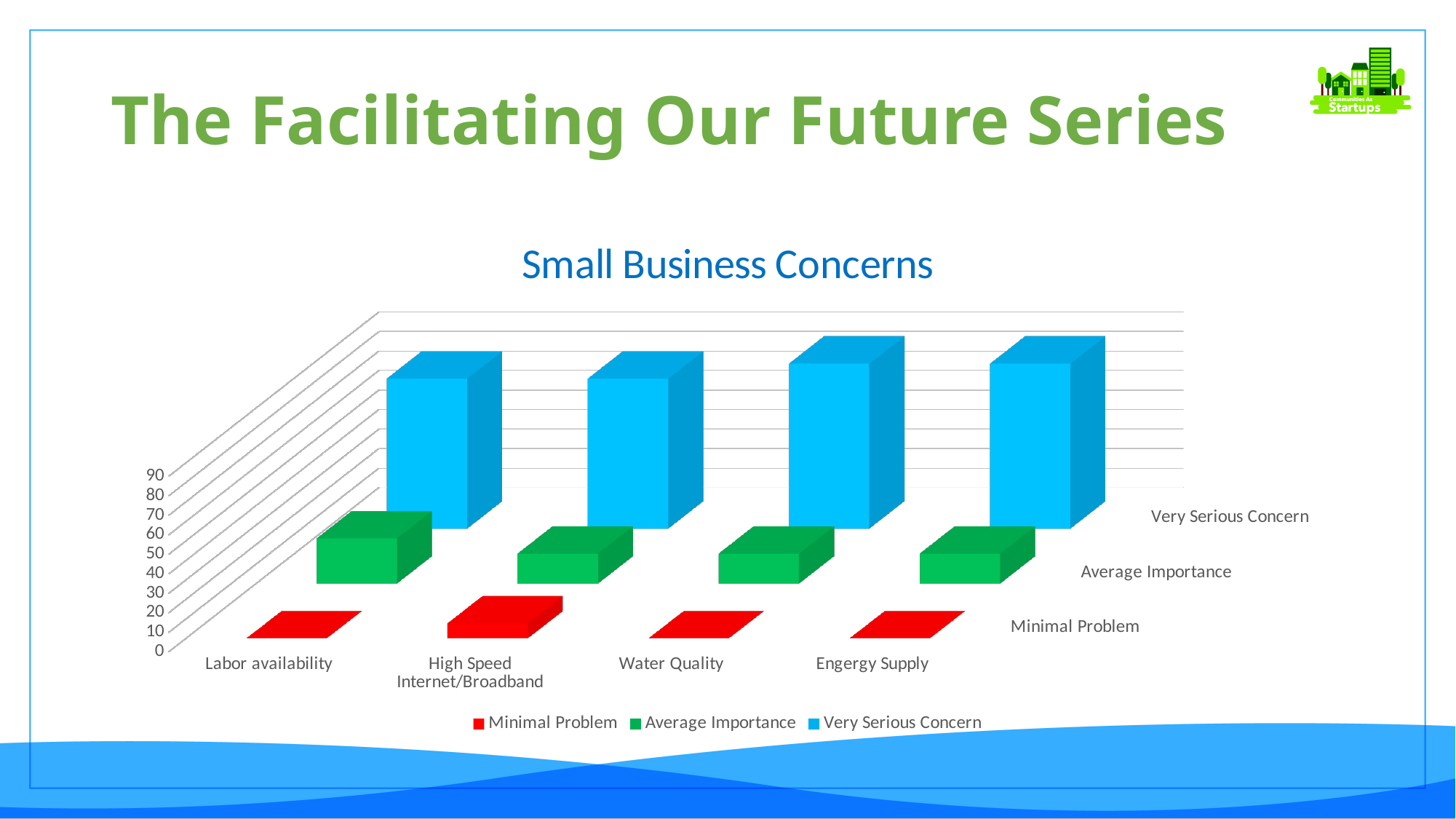
How many series does the chart's legend list? 3 Which category has the highest Average Importance value? Labor availability How many categories are shown on the x axis of the chart? 4 Which series has the highest value for Water Quality? Very Serious Concern Is the Very Serious Concern value for Engergy Supply greater or less than 50? greater Which series has the lowest value for Labor availability? Minimal Problem What kind of chart is shown on the slide? bar chart Is the Minimal Problem value for Water Quality greater or less than 10? less Which series is shown in blue in the chart? Very Serious Concern Is the Average Importance value for Labor availability larger or smaller than the Average Importance value for Water Quality? larger What is the title of the chart? Small Business Concerns Is the Very Serious Concern value for Water Quality larger or smaller than the Very Serious Concern value for Labor availability? larger